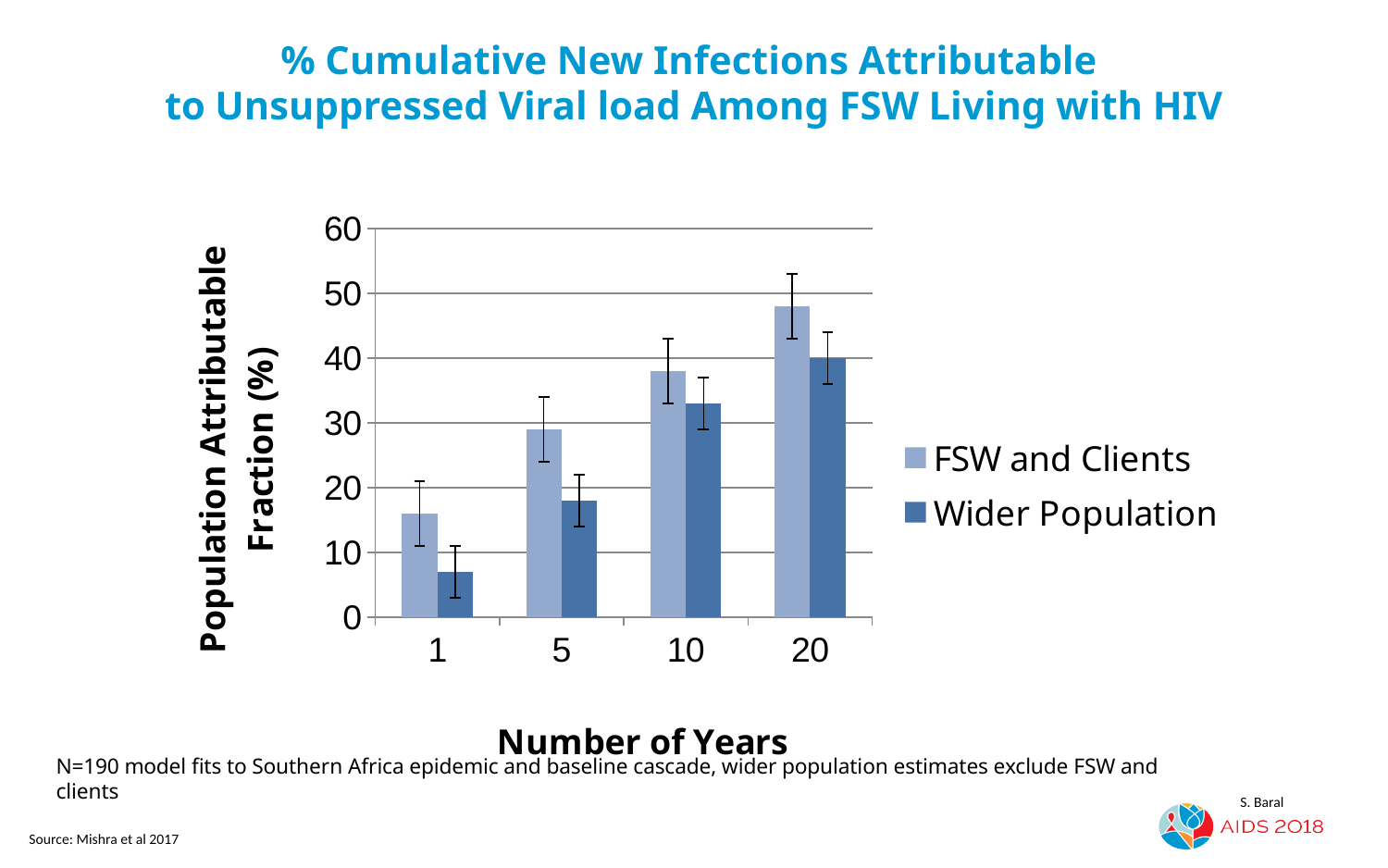
Which number of years has the lowest value for Wider Population? 1 Do the values for Wider Population rise or fall as the number of years increases? rise How many categories are shown on the x axis? 4 What kind of chart is shown on the slide? bar chart How many series does the legend list? 2 Is the value for FSW and Clients at 5 years greater or less than 20? greater Is the value for Wider Population at 1 year greater or less than 10? less Is the value for Wider Population at 10 years greater or less than 40? less Which number of years has the highest value for FSW and Clients? 20 At 1 year, which series has the larger value, FSW and Clients or Wider Population? FSW and Clients What is the label of the y axis? Population Attributable Fraction (%)